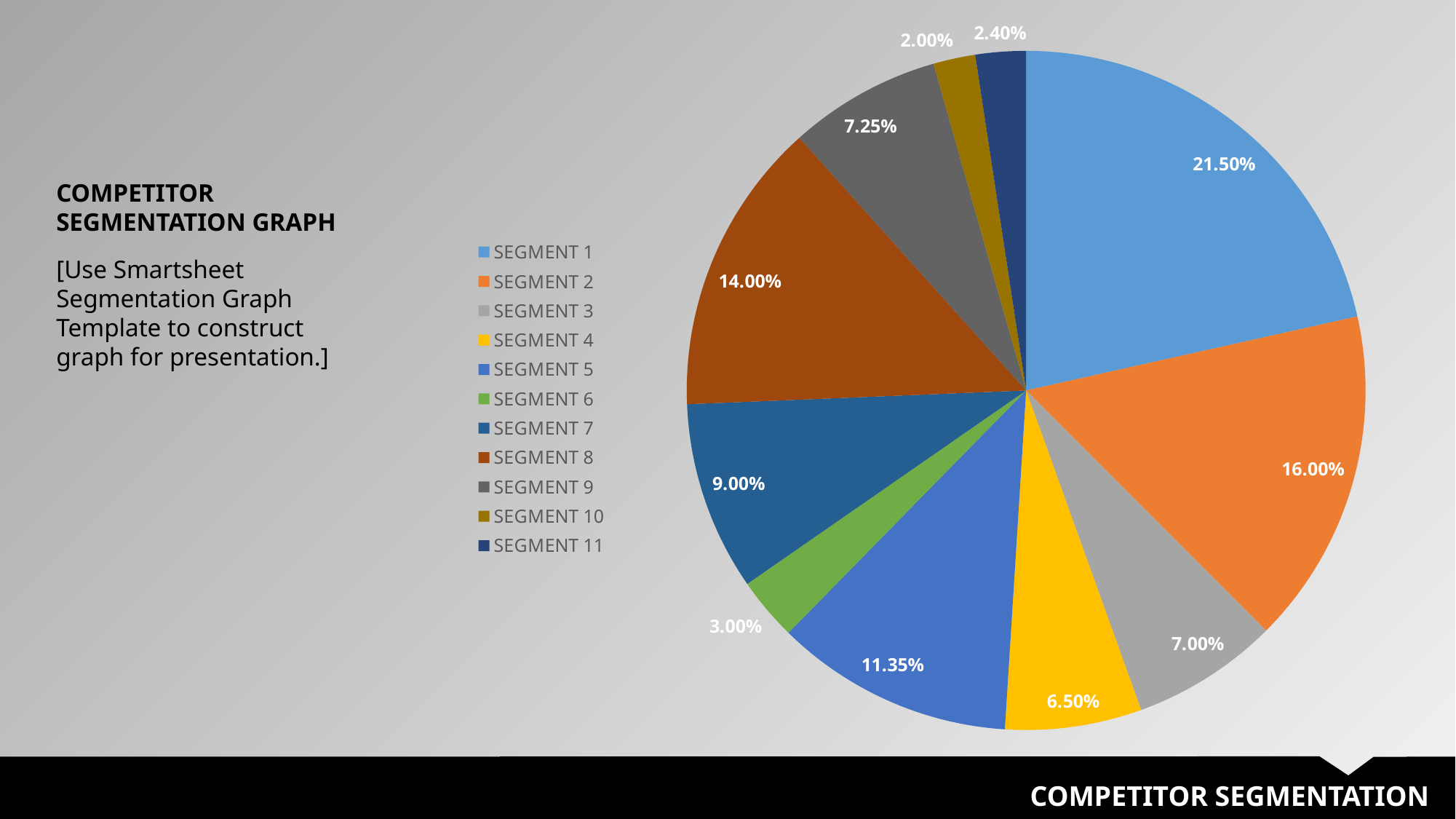
What is the value for Segment 10? 2.00% Which segment has the largest share of the pie? Segment 1 How many segments does the pie chart have? 11 What is the difference between the values for Segment 2 and Segment 3? 9.00% Which segment has the smallest share of the pie? Segment 10 Which is larger, the value for Segment 7 or the value for Segment 9? Segment 7 What is the value for Segment 1? 21.50% What is the difference between the values for Segment 11 and Segment 6? 0.60% What is the value for Segment 8? 14.00% What colour is the slice for Segment 4? yellow What is the value for Segment 5? 11.35% What kind of chart is shown on the slide? pie chart